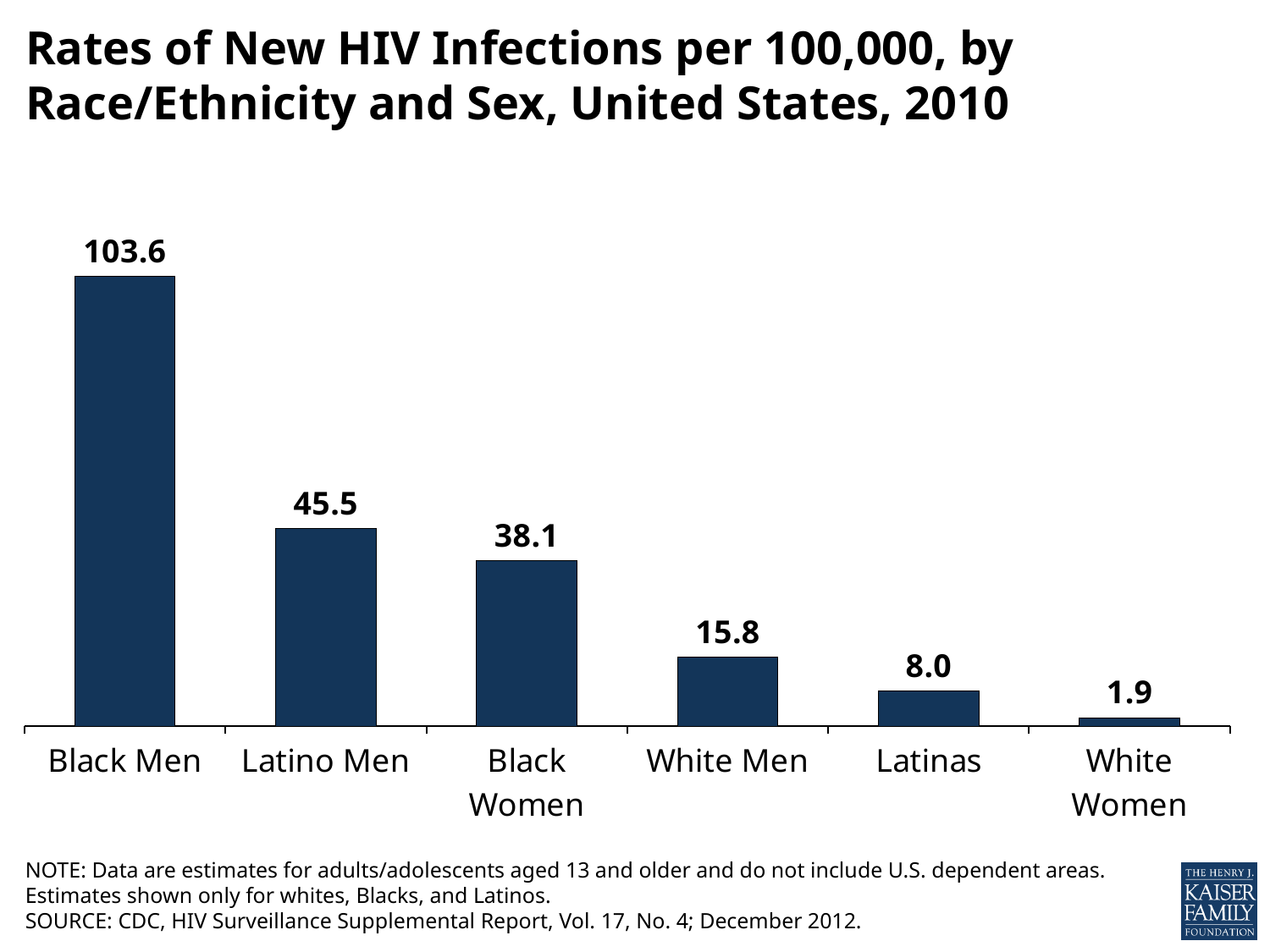
What is the rate of new HIV infections per 100,000 for Latinas? 8.0 Do the values rise or fall moving from left to right along the x axis? Fall What is the difference between the rates for Black Men and White Men? 87.8 What is the difference between the rates for Latino Men and Black Women? 7.4 Which category has the lowest rate of new HIV infections? White Women Which category has the highest rate of new HIV infections? Black Men Which is larger, the rate for White Men or the rate for Latinas? White Men What is the rate of new HIV infections per 100,000 for White Women? 1.9 What is the title of the chart? Rates of New HIV Infections per 100,000, by Race/Ethnicity and Sex, United States, 2010 How many categories are shown on the chart? 6 What is the rate of new HIV infections per 100,000 for Black Men? 103.6 What kind of chart is shown on the slide? Bar chart